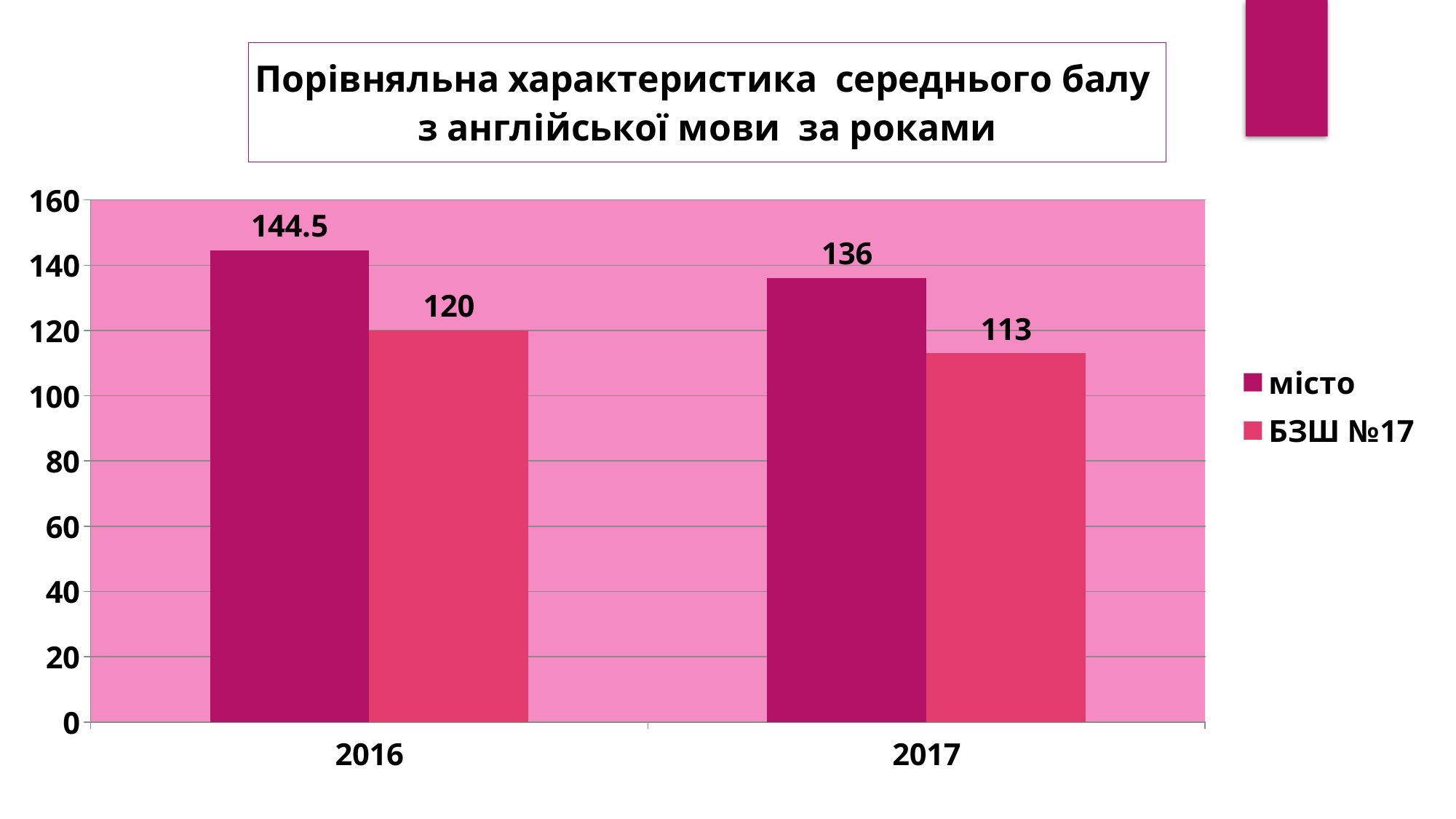
How many years are shown on the x axis? 2 What is the difference between місто and БЗШ №17 in 2016? 24.5 What is the value for місто in 2016? 144.5 Which year has the highest value for місто? 2016 Is the value for місто in 2017 greater or less than 140? less Which is larger in 2017: місто or БЗШ №17? місто How many series does the legend list? 2 What is the value for місто in 2017? 136 What is the value for БЗШ №17 in 2017? 113 What is the value for БЗШ №17 in 2016? 120 Which year has the lowest value for БЗШ №17? 2017 What kind of chart is shown on the slide? bar chart